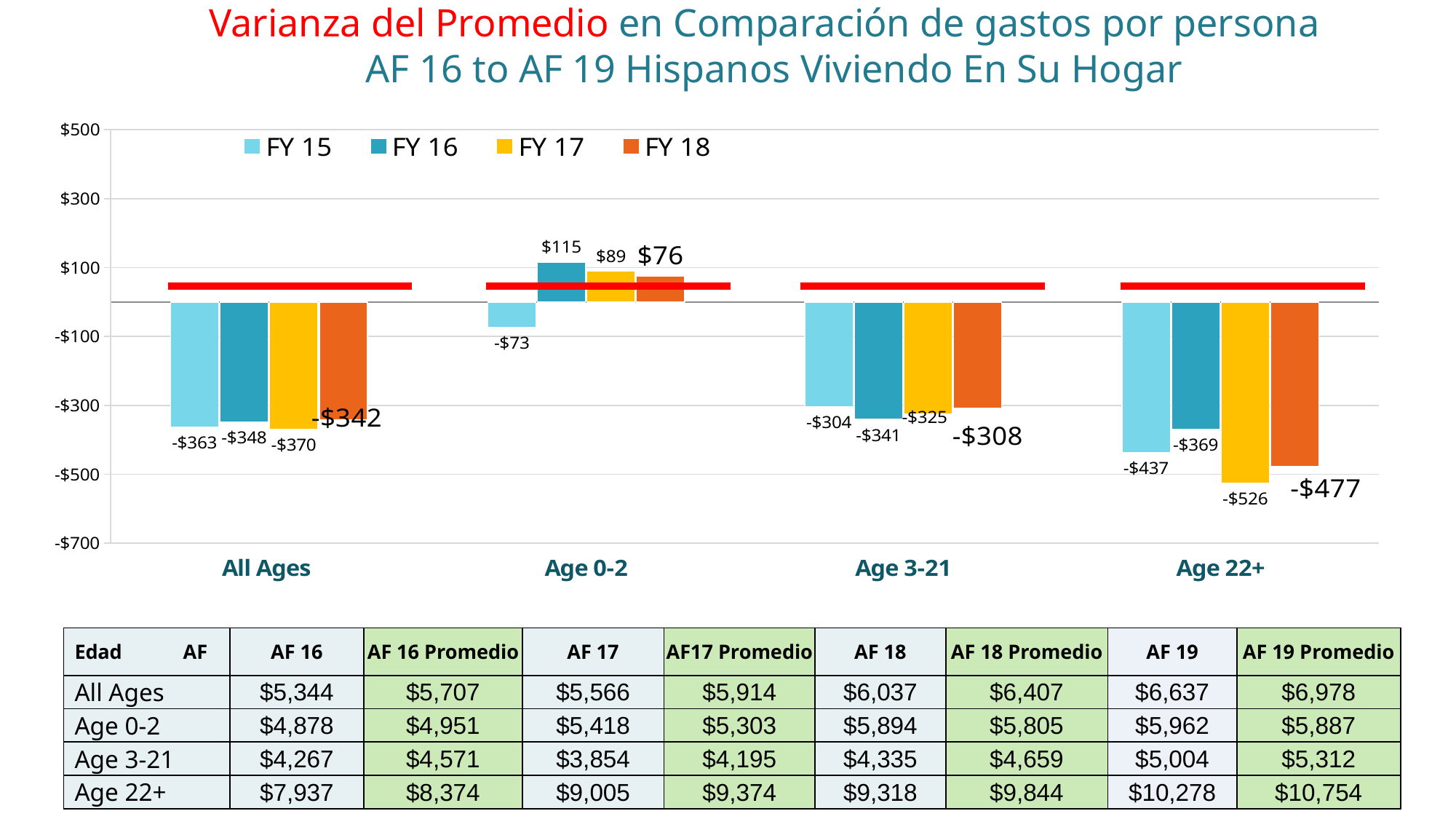
What is the difference between the FY 16 and FY 15 values for Age 0-2? $188 How many age groups are shown on the x axis of the chart? 4 What is the FY 16 value for Age 0-2? $115 Which series is shown in orange in the chart legend? FY 18 How many series does the chart legend list? 4 Which age group has the highest FY 18 value? Age 0-2 What kind of chart is shown on the slide? Bar chart Which age group has the lowest FY 17 value? Age 22+ What is the FY 18 value for Age 3-21? -$308 What is the FY 15 value for All Ages? -$363 Which is larger, the FY 15 value for Age 22+ or the FY 16 value for Age 22+? FY 16 What is the FY 17 value for Age 22+? -$526